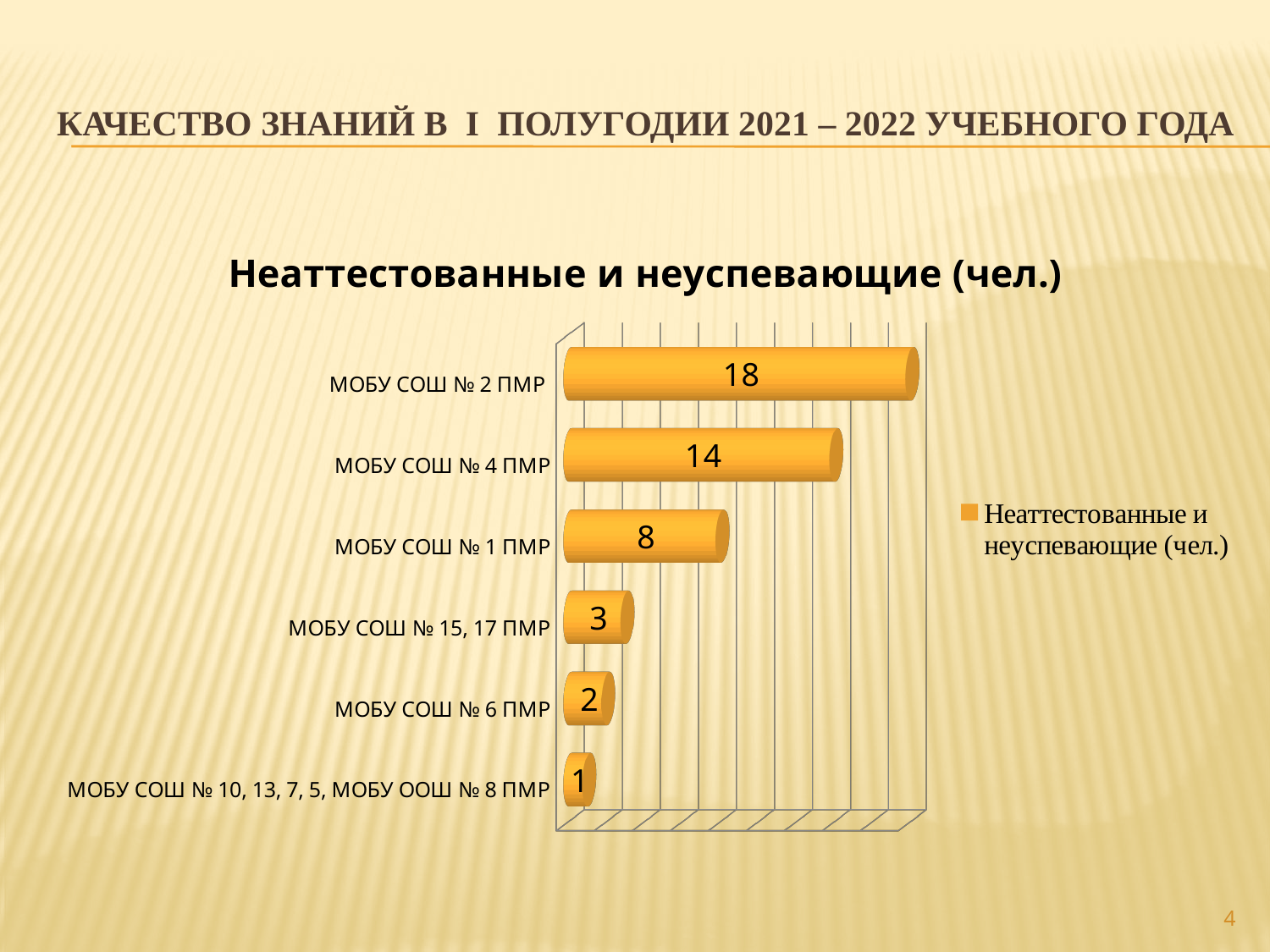
What is the value for МОБУ СОШ № 15, 17 ПМР? 3 What is the title of the chart? Неаттестованные и неуспевающие (чел.) How many categories are shown in the chart? 6 Which category has the highest value? МОБУ СОШ № 2 ПМР What kind of chart is shown? Bar chart What is the value for МОБУ СОШ № 2 ПМР? 18 How many series does the legend list? 1 What is the difference between the values for МОБУ СОШ № 2 ПМР and МОБУ СОШ № 4 ПМР? 4 What is the value for МОБУ СОШ № 4 ПМР? 14 What is the value for МОБУ СОШ № 1 ПМР? 8 Which is larger, the value for МОБУ СОШ № 1 ПМР or the value for МОБУ СОШ № 6 ПМР? МОБУ СОШ № 1 ПМР Which category has the lowest value? МОБУ СОШ № 10, 13, 7, 5, МОБУ ООШ № 8 ПМР